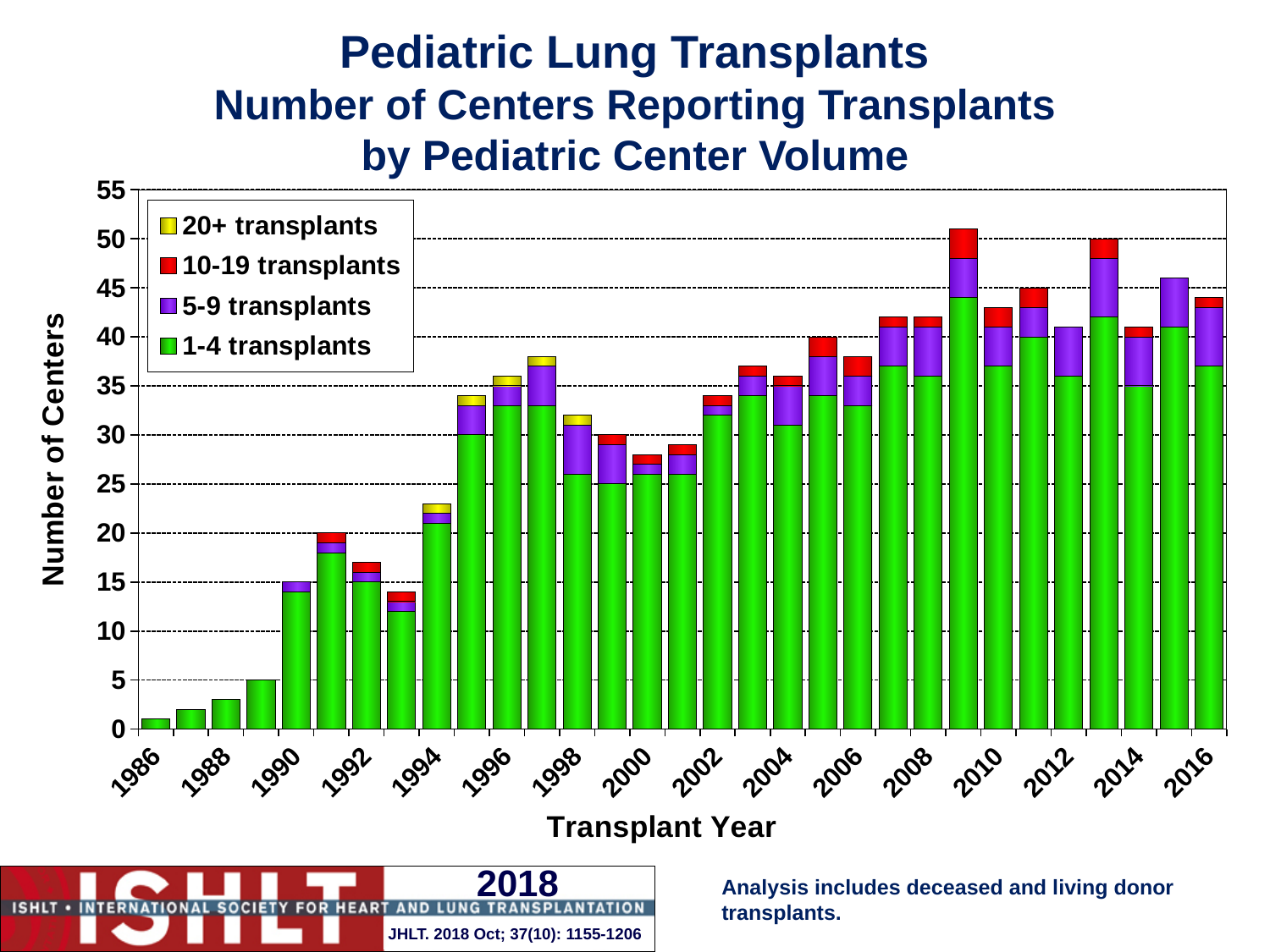
Is the total number of centers for 2009 greater or less than 50? greater How many series does the legend list? 4 What colour represents the '20+ transplants' series in the legend? Yellow What kind of chart is shown on the slide? Stacked bar chart Which year has more centers reporting in total, 1990 or 1995? 1995 How many transplant years (bars) are plotted on the chart? 31 Does the total number of centers rise or fall from 1986 to 1990? Rise Is the total number of centers for 2011 greater or less than 40? greater Which transplant year has the lowest total number of centers? 1986 Is the total number of centers for 1990 greater or less than 20? less Which year has more centers reporting in total, 1999 or 2003? 2003